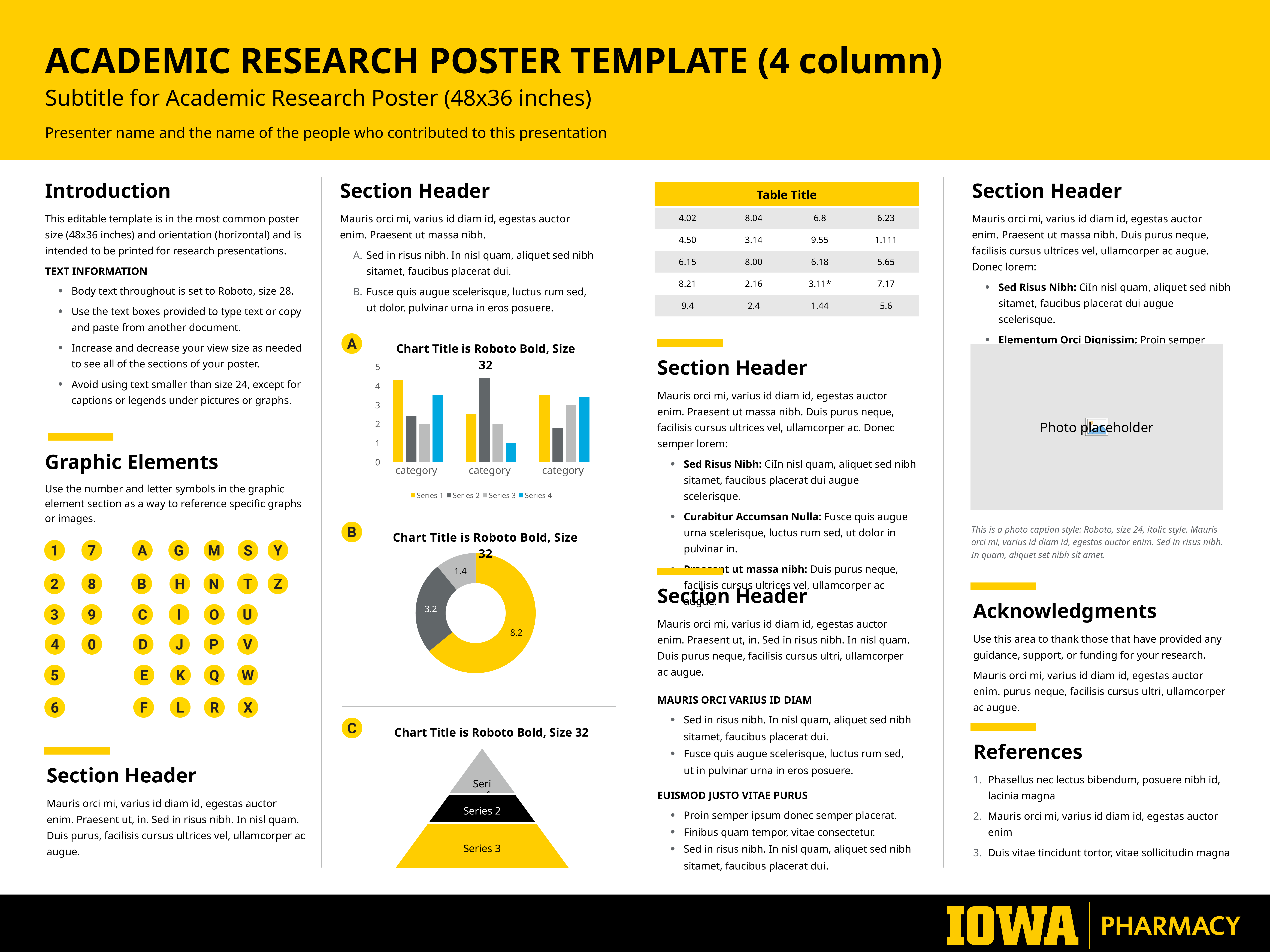
What kind of chart is chart B (the middle chart in the second column)? doughnut chart In chart A, which series has the lowest bar in the second category? Series 4 In chart A, which series has the highest bar in the first category? Series 1 How many categories are shown on the x axis of chart A? 3 What kind of chart is chart A (the top chart in the second column)? bar chart In chart B, what colour is the slice labelled 8.2? yellow In chart B, what is the difference between the largest slice (8.2) and the dark grey slice (3.2)? 5.0 In chart B, what is the value of the smallest slice? 1.4 In chart B, what is the value of the largest slice? 8.2 In chart A, is the Series 4 value for the second category greater or less than 2? less In chart A, is the Series 2 value for the second category greater or less than 4? greater How many series does the legend of chart A list? 4